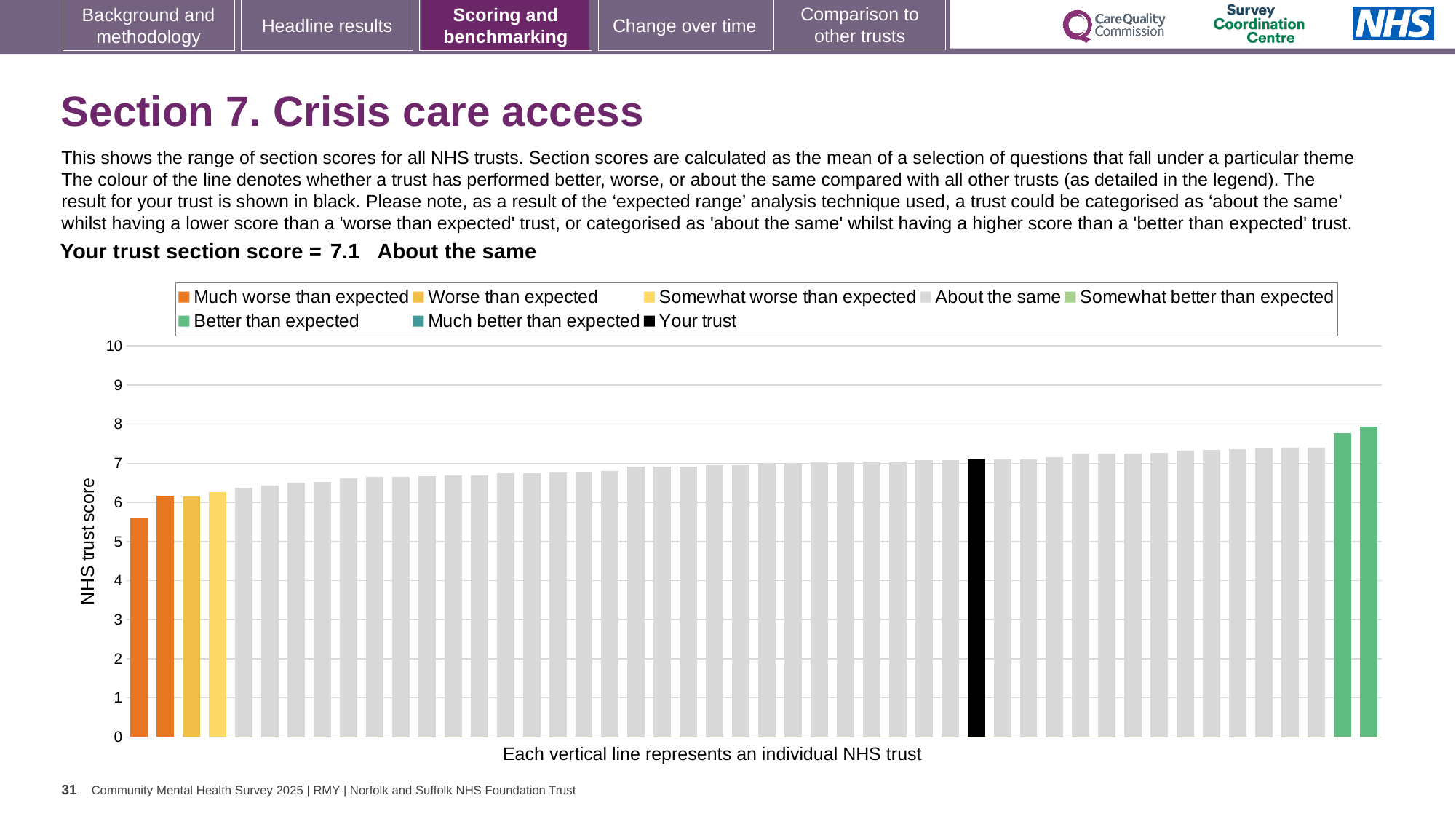
What kind of chart is shown on the slide? bar chart Do the bar values rise or fall from left to right along the x axis? rise How many bars are coloured as 'Better than expected' (green)? 2 Is the value of the leftmost (lowest) bar greater or less than 6? less How is your trust's section score categorised compared with other trusts? About the same How many entries does the chart legend list? 8 Is the value of the rightmost (highest) bar greater or less than 7? greater Is the value of the black bar for your trust greater or less than 7? greater What is the section score for your trust shown on the slide? 7.1 How many bars are coloured as 'Much worse than expected' (orange)? 2 Which is larger, the leftmost bar or the rightmost bar? the rightmost bar What is the label on the vertical axis of the chart? NHS trust score